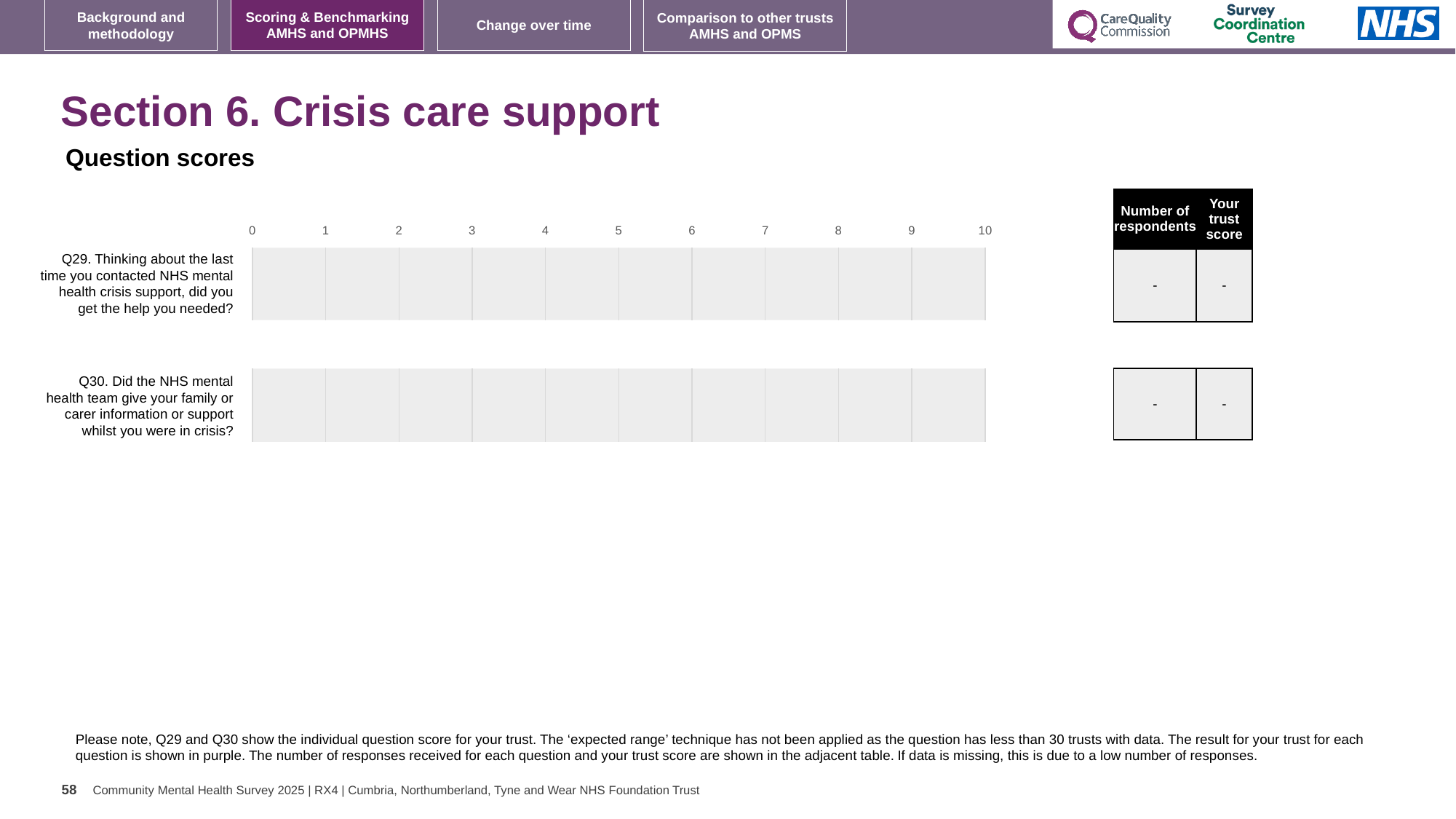
What is the heading shown above the chart? Question scores How many questions (categories) are listed on the chart? 2 What is the highest value shown on the chart's horizontal axis? 10 What is shown in the 'Number of respondents' column for Q30? - What is shown in the 'Your trust score' column for Q29? - What kind of chart is shown on the slide? bar chart